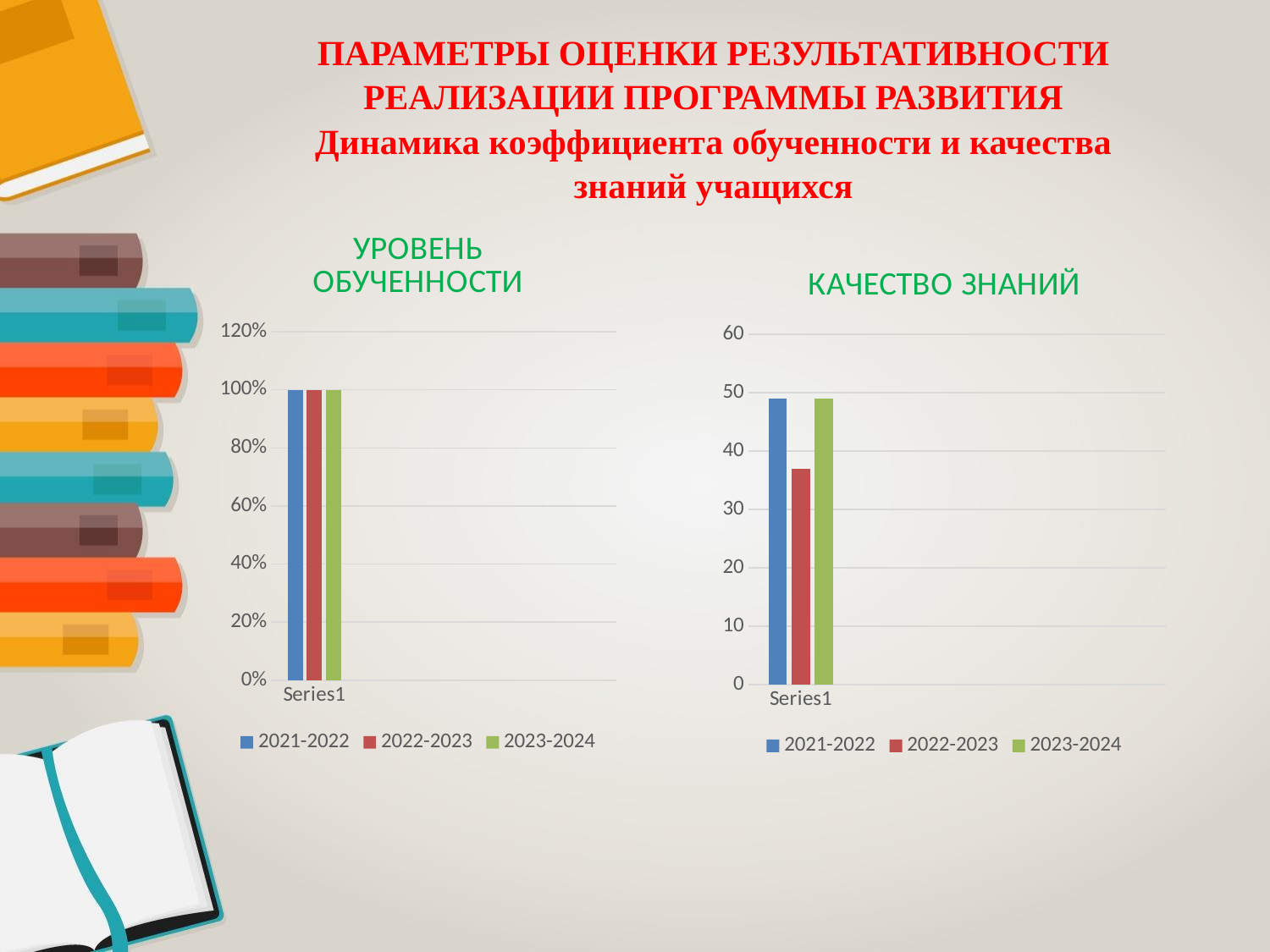
In the 'КАЧЕСТВО ЗНАНИЙ' chart, which colour represents the 2023-2024 series? green In the 'КАЧЕСТВО ЗНАНИЙ' chart, is the value for 2022-2023 greater or less than 40? less In the 'КАЧЕСТВО ЗНАНИЙ' chart, which series has the lowest value? 2022-2023 What kind of chart is the 'КАЧЕСТВО ЗНАНИЙ' chart? bar chart In the 'КАЧЕСТВО ЗНАНИЙ' chart, which is larger, the value for 2021-2022 or for 2022-2023? 2021-2022 In the 'УРОВЕНЬ ОБУЧЕННОСТИ' chart, what is the value for 2021-2022? 100% In the 'КАЧЕСТВО ЗНАНИЙ' chart, is the value for 2021-2022 greater or less than 40? greater What is the title of the chart on the right side of the slide? КАЧЕСТВО ЗНАНИЙ How many series does the legend of the 'КАЧЕСТВО ЗНАНИЙ' chart list? 3 How many series does the legend of the 'УРОВЕНЬ ОБУЧЕННОСТИ' chart list? 3 In the 'УРОВЕНЬ ОБУЧЕННОСТИ' chart, what is the value for 2023-2024? 100%